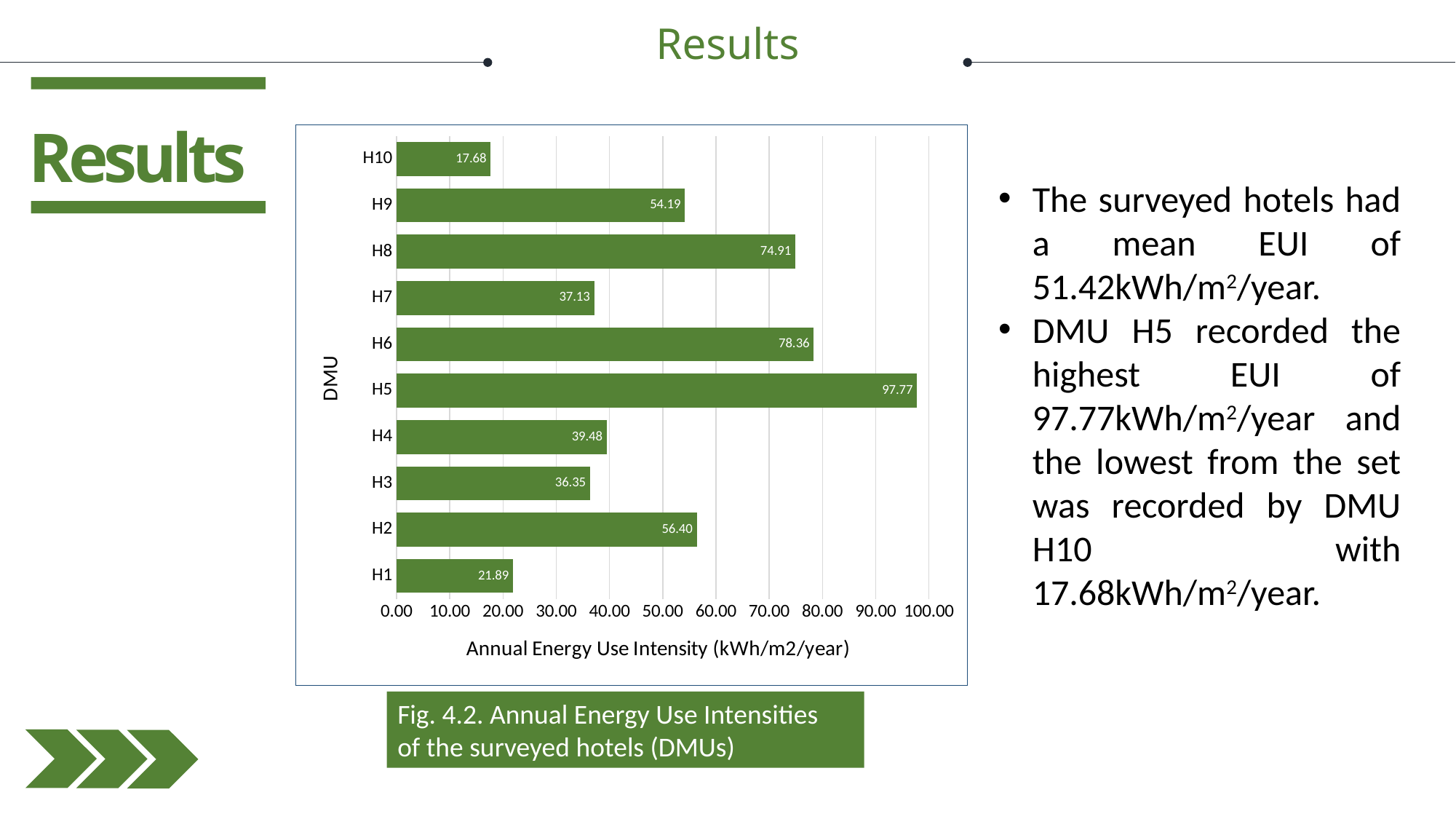
What kind of chart is shown on the slide? bar chart Which DMU has the highest annual energy use intensity? H5 What is the figure caption below the chart? Fig. 4.2. Annual Energy Use Intensities of the surveyed hotels (DMUs) Which DMU has the lowest annual energy use intensity? H10 Is the value for H4 greater or less than 40.00? less What is the difference between the annual energy use intensity of H6 and H7? 41.23 What is the annual energy use intensity for H1? 21.89 How many DMUs are shown in the chart? 10 What is the annual energy use intensity for H5? 97.77 Which has a higher annual energy use intensity, H2 or H9? H2 What is the annual energy use intensity for H8? 74.91 What is the label of the horizontal axis of the chart? Annual Energy Use Intensity (kWh/m2/year)